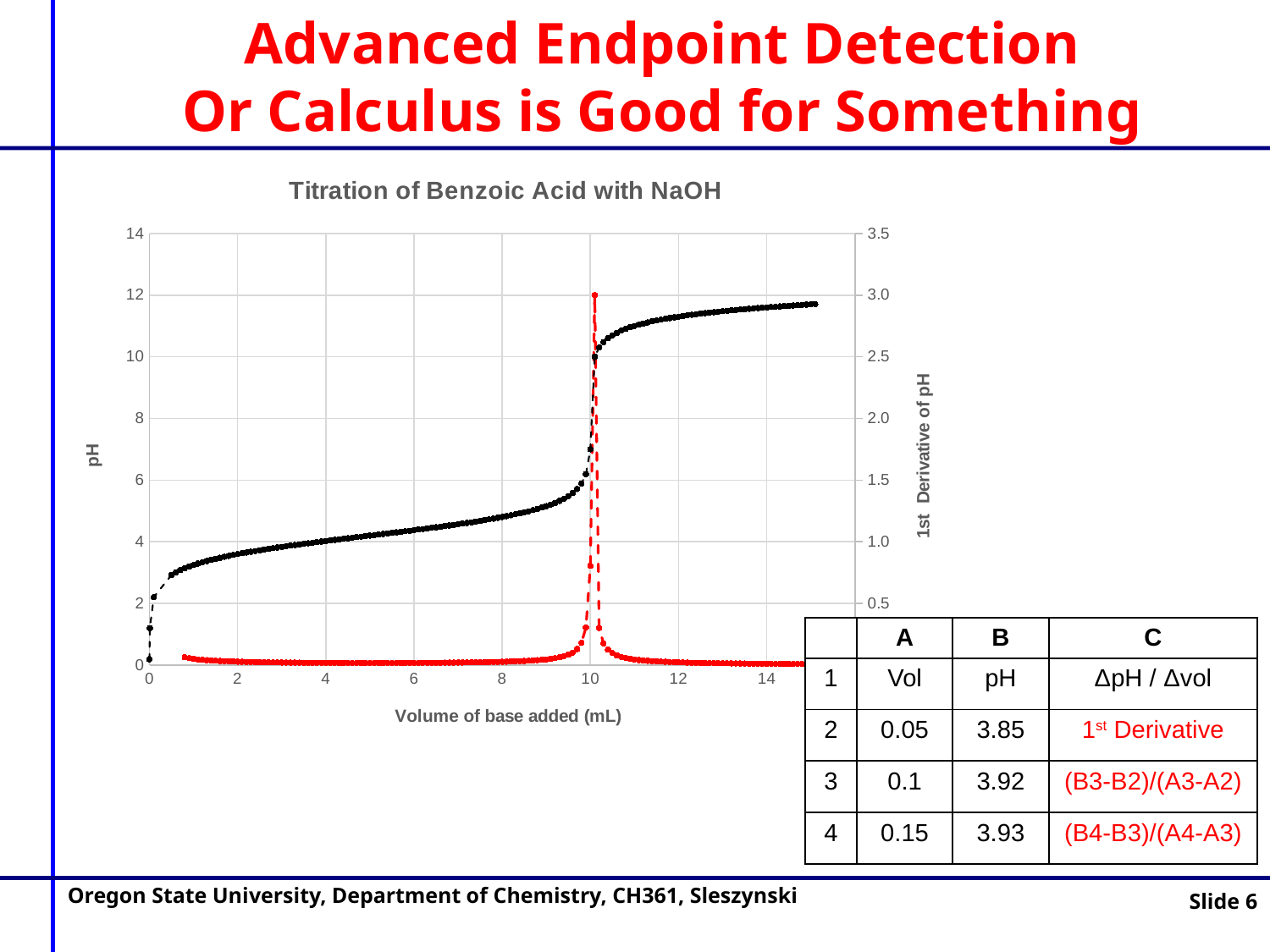
Is the pH at 4 mL of base added greater or less than 6? less Is the 1st derivative of pH at 4 mL of base added greater or less than 0.5? less Which is larger: the pH at 12 mL of base added or the pH at 2 mL of base added? pH at 12 mL Is the peak of the red 1st derivative curve greater or less than 2.5 on the right axis? greater How many data series are plotted on the chart? 2 What kind of chart is shown on the slide? line chart Which is larger: the 1st derivative of pH at 10 mL of base added or at 5 mL of base added? at 10 mL According to the data table on the slide, what is the pH when the volume of base added is 0.1 mL? 3.92 Does the black pH curve rise or fall as the volume of base added increases? rise What is the label of the right-hand vertical axis of the chart? 1st Derivative of pH What is the title of the chart? Titration of Benzoic Acid with NaOH